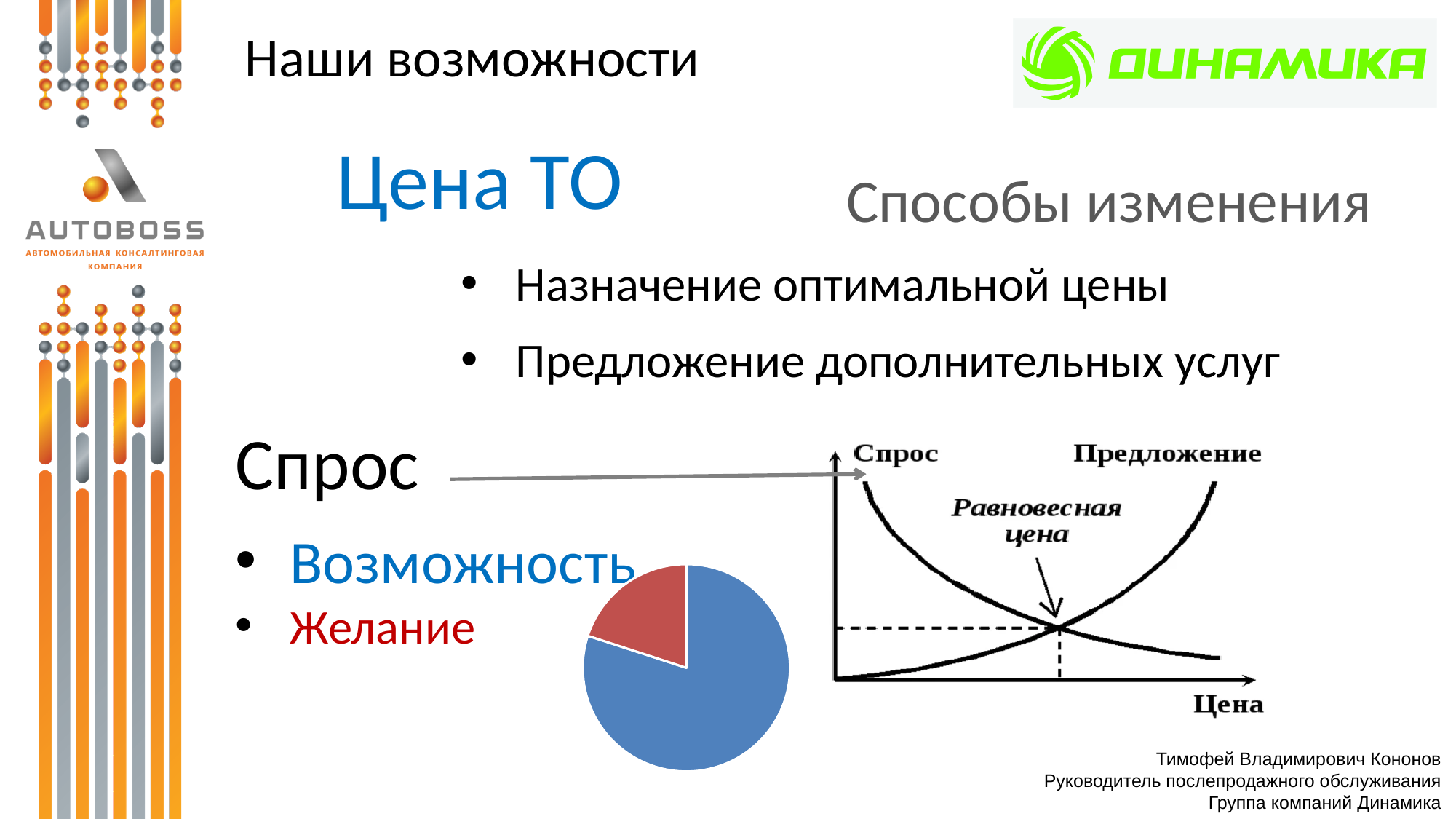
What two colours are used for the slices of the pie chart at the bottom centre of the slide? blue and red In the pie chart at the bottom centre of the slide, which slice is the smallest? the red slice How many slices does the pie chart at the bottom centre of the slide have? 2 In the supply-and-demand diagram on the right of the slide, does the curve labelled "Предложение" rise or fall as it moves to the right along the x axis? rise In the pie chart at the bottom centre of the slide, which slice is larger, the blue one or the red one? the blue one How many curves are drawn in the supply-and-demand diagram on the right of the slide? 2 In the supply-and-demand diagram on the right of the slide, what is the point where the two curves cross labelled? Равновесная цена In the pie chart at the bottom centre of the slide, is the blue slice more or less than half of the pie? more In the supply-and-demand diagram on the right of the slide, does the curve labelled "Спрос" rise or fall as it moves to the right along the x axis? fall In the supply-and-demand diagram on the right of the slide, what is the label on the horizontal axis? Цена What kind of chart is shown at the bottom centre of the slide, below the word "Спрос"? pie chart